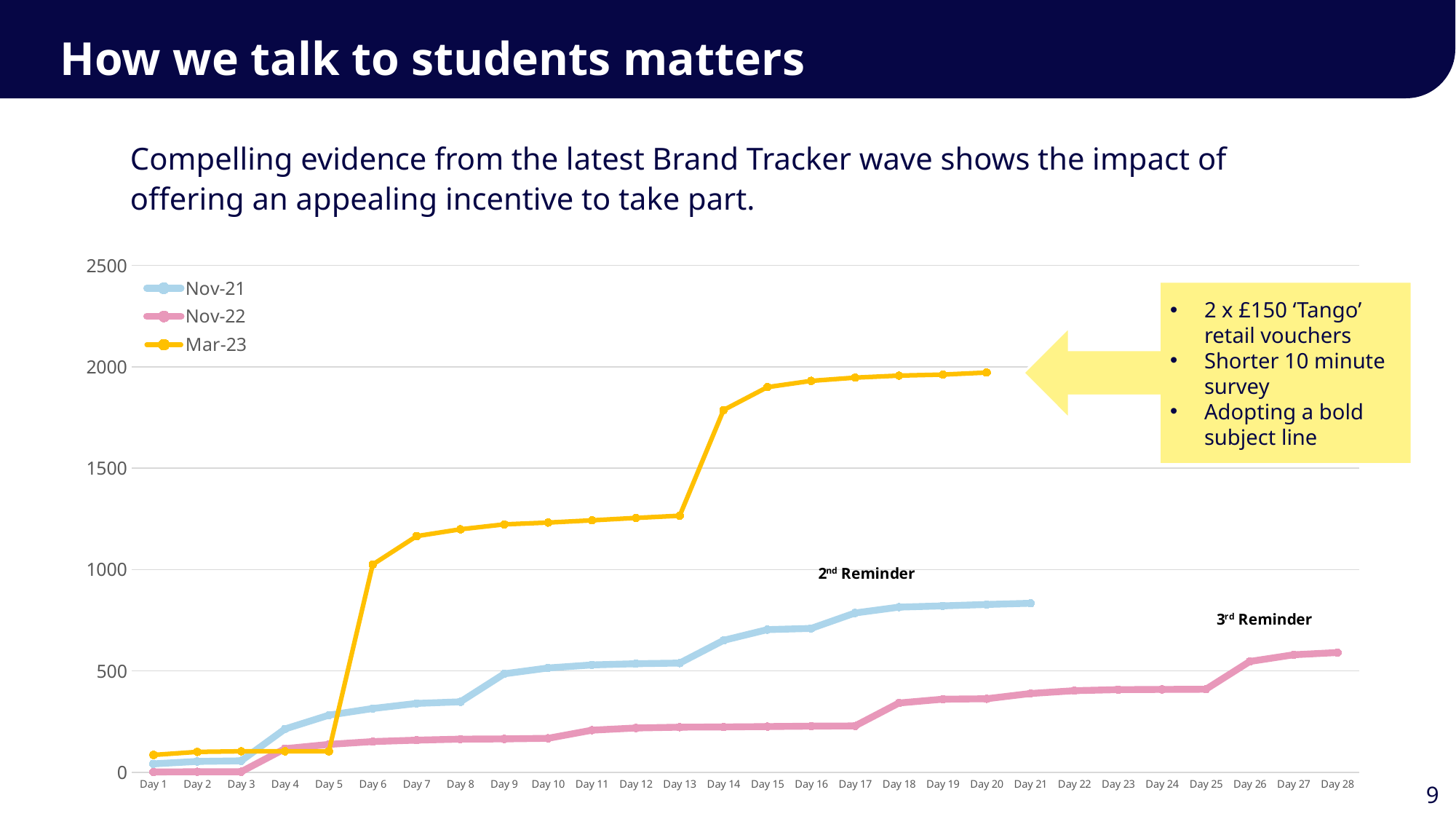
On Day 14, which is larger: the value for Mar-23 or the value for Nov-21? Mar-23 Which series has the lowest value on Day 20? Nov-22 Which series reaches the highest value on the chart? Mar-23 Do the values for Mar-23 rise or fall from Day 1 to Day 20? rise Is the value for Nov-21 on Day 21 greater or less than 1000? less Which series are listed in the chart legend? Nov-21, Nov-22, Mar-23 Is the value for Nov-22 on Day 28 greater or less than 500? greater What kind of chart is shown on the slide? line chart How many series does the legend list? 3 How many days are shown along the x axis? 28 Is the value for Mar-23 on Day 20 greater or less than 1500? greater